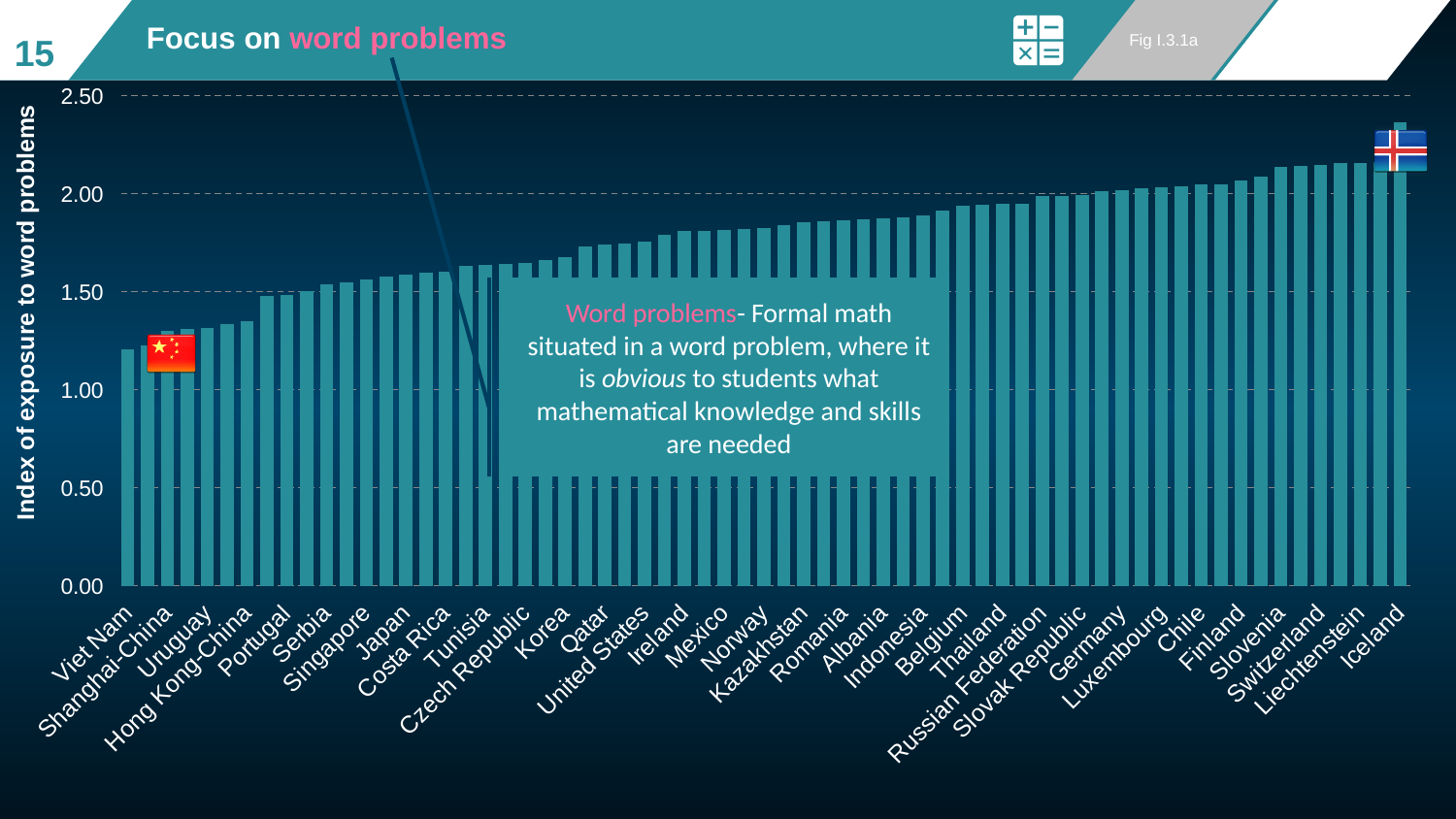
Is the value for Uruguay greater or less than 1.50? less Which country has the lowest index of exposure to word problems? Viet Nam Is the value for Iceland greater or less than 2.00? greater Is the value for Switzerland greater or less than 2.00? greater What is the title of the vertical axis? Index of exposure to word problems Do the bar values rise or fall moving from left to right along the x axis? rise Which has the larger index of exposure to word problems, Korea or Uruguay? Korea Which country has the highest index of exposure to word problems? Iceland What kind of chart is shown on the slide? bar chart